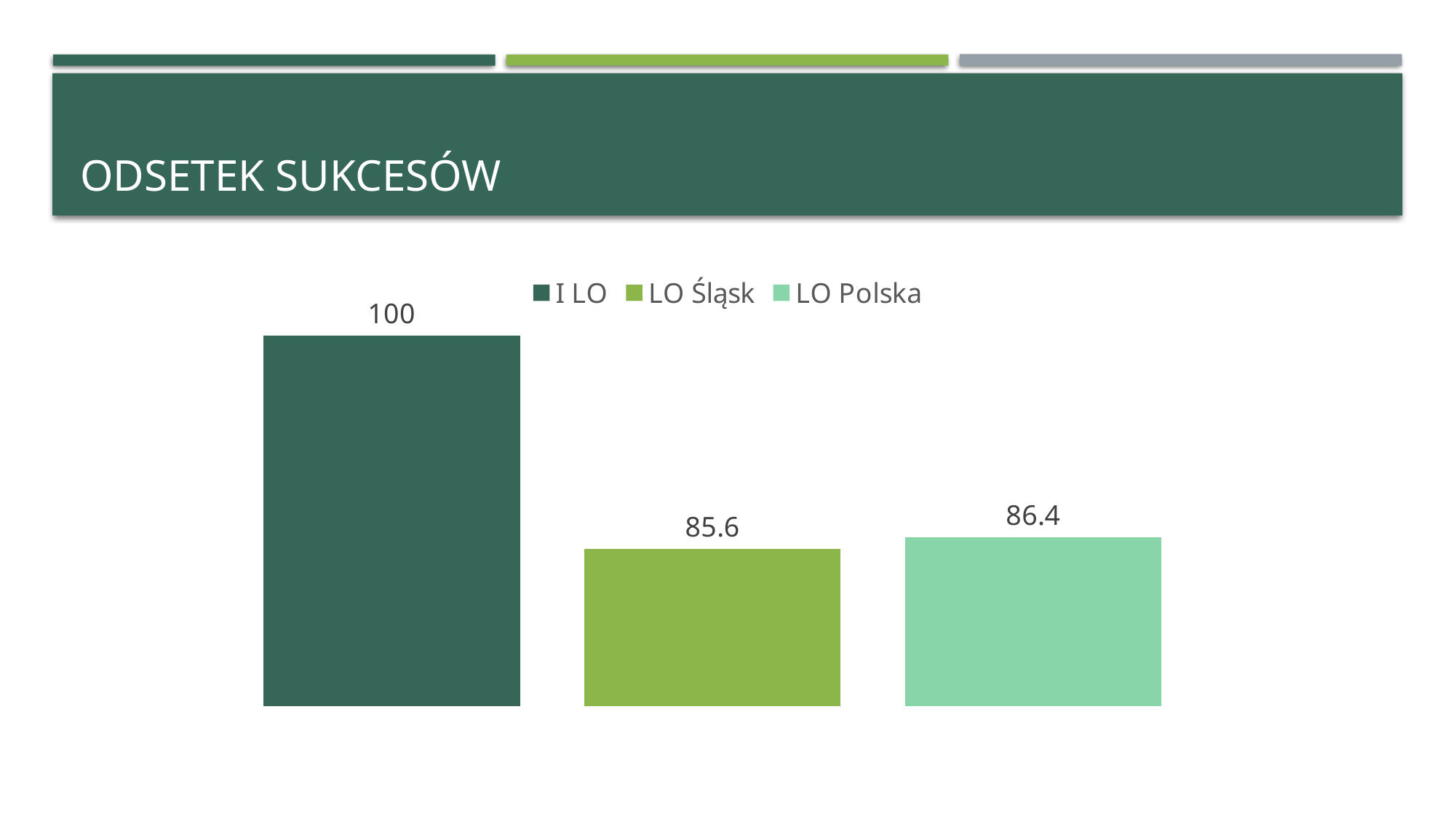
What kind of chart is shown on the slide? Bar chart Which series has the highest value? I LO Which series has the lowest value? LO Śląsk What is the difference between the values for LO Polska and LO Śląsk? 0.8 What is the value for LO Polska? 86.4 Which is larger, the value for I LO or the value for LO Polska? I LO What is the value for I LO? 100 How many bars are plotted in the chart? 3 What is the value for LO Śląsk? 85.6 What is the difference between the values for I LO and LO Śląsk? 14.4 What is the title of the slide containing the chart? ODSETEK SUKCESÓW How many series does the legend list? 3